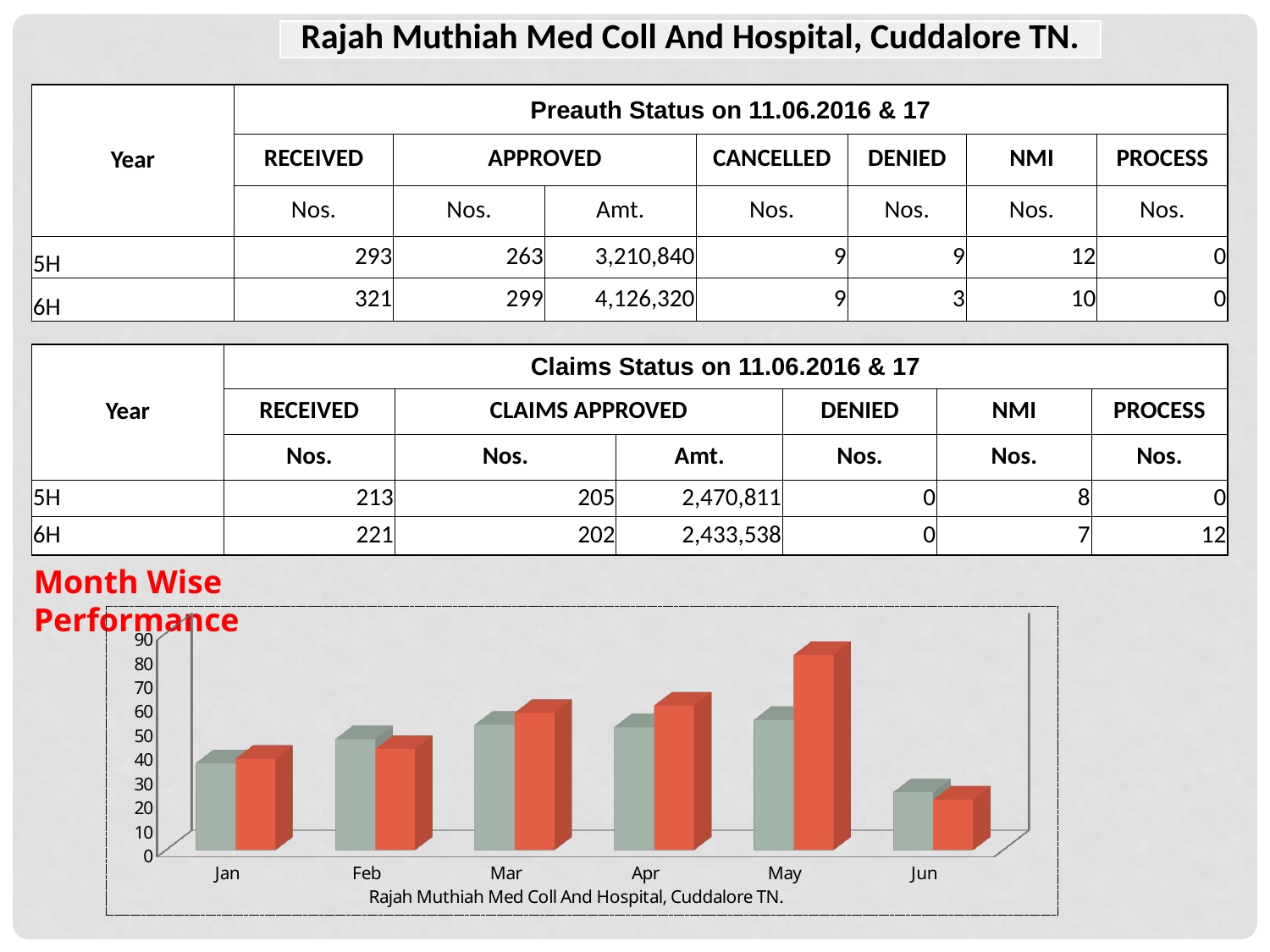
In the Month Wise Performance chart, which is larger: the red bar for May or the red bar for Jun? May In the Month Wise Performance chart, is the grey bar for Jan greater or less than 50? less In the Month Wise Performance chart, is the red bar for May greater or less than 70? greater In the Month Wise Performance chart, which month has the tallest bar? May In the Month Wise Performance chart, is the red bar for Apr greater or less than 50? greater What kind of chart is shown under the heading "Month Wise Performance"? bar chart In the Month Wise Performance chart, which month has the shortest bars? Jun What title is printed below the x axis of the Month Wise Performance chart? Rajah Muthiah Med Coll And Hospital, Cuddalore TN. How many months are shown on the x axis of the Month Wise Performance chart? 6 In the Month Wise Performance chart, do the red bars rise or fall from Apr to Jun? rise then fall In the Month Wise Performance chart, which is larger: the grey bar for Jan or the grey bar for Feb? Feb